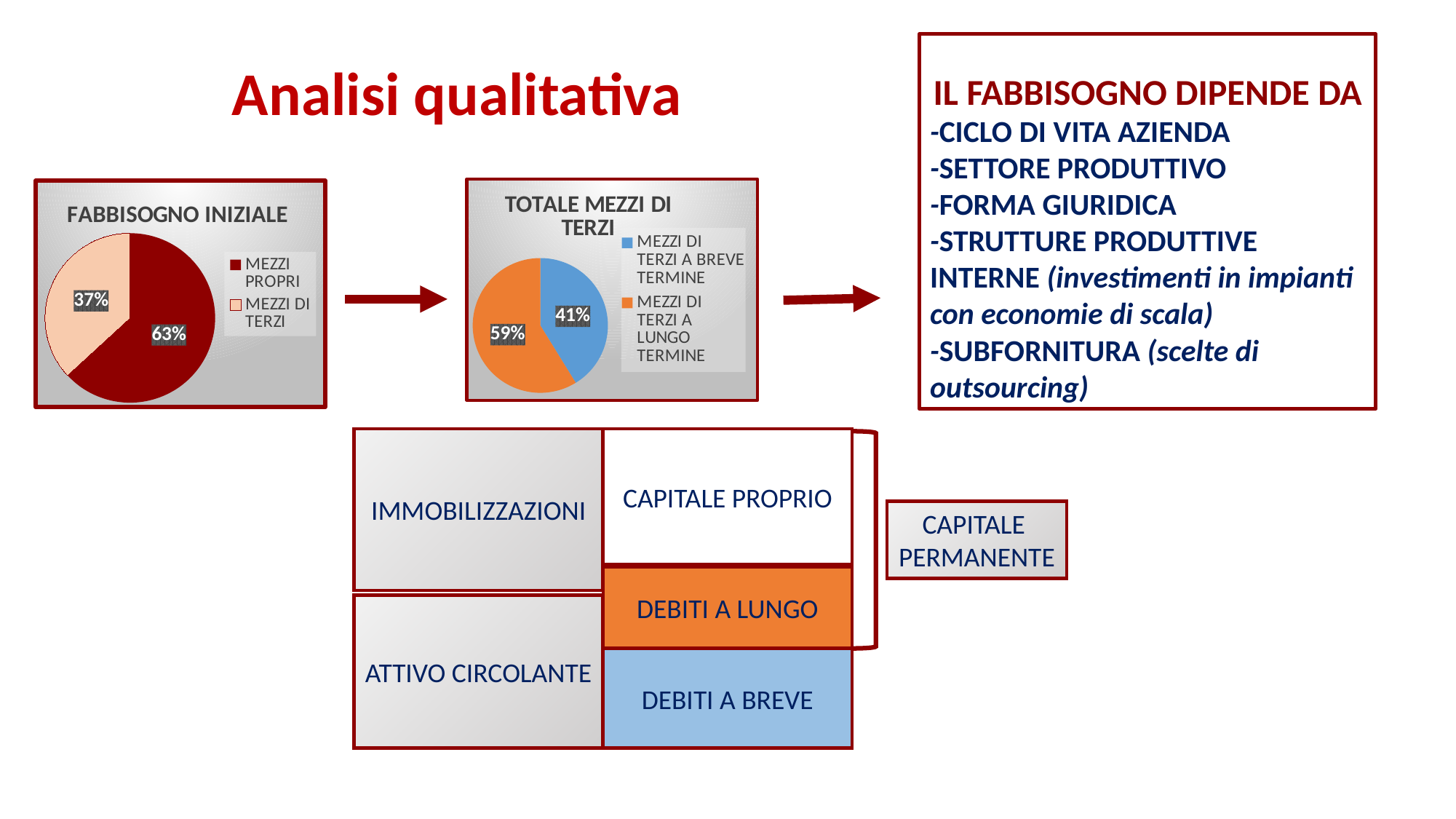
In the 'TOTALE MEZZI DI TERZI' chart, what share is MEZZI DI TERZI A BREVE TERMINE? 41% In the 'TOTALE MEZZI DI TERZI' chart, which slice is the smallest? MEZZI DI TERZI A BREVE TERMINE In the 'FABBISOGNO INIZIALE' chart, which slice is the largest? MEZZI PROPRI In the 'FABBISOGNO INIZIALE' chart, what share is MEZZI DI TERZI? 37% In the 'TOTALE MEZZI DI TERZI' chart, what colour is the MEZZI DI TERZI A LUNGO TERMINE slice? Orange How many slices does the 'FABBISOGNO INIZIALE' chart have? 2 In the 'TOTALE MEZZI DI TERZI' chart, what is the difference between the two slices? 18% In the 'TOTALE MEZZI DI TERZI' chart, what share is MEZZI DI TERZI A LUNGO TERMINE? 59% In the 'FABBISOGNO INIZIALE' chart, what is the difference between MEZZI PROPRI and MEZZI DI TERZI? 26% In the 'FABBISOGNO INIZIALE' chart, what share is MEZZI PROPRI? 63% In the 'TOTALE MEZZI DI TERZI' chart, is MEZZI DI TERZI A LUNGO TERMINE larger or smaller than MEZZI DI TERZI A BREVE TERMINE? Larger What kind of chart is 'FABBISOGNO INIZIALE'? Pie chart